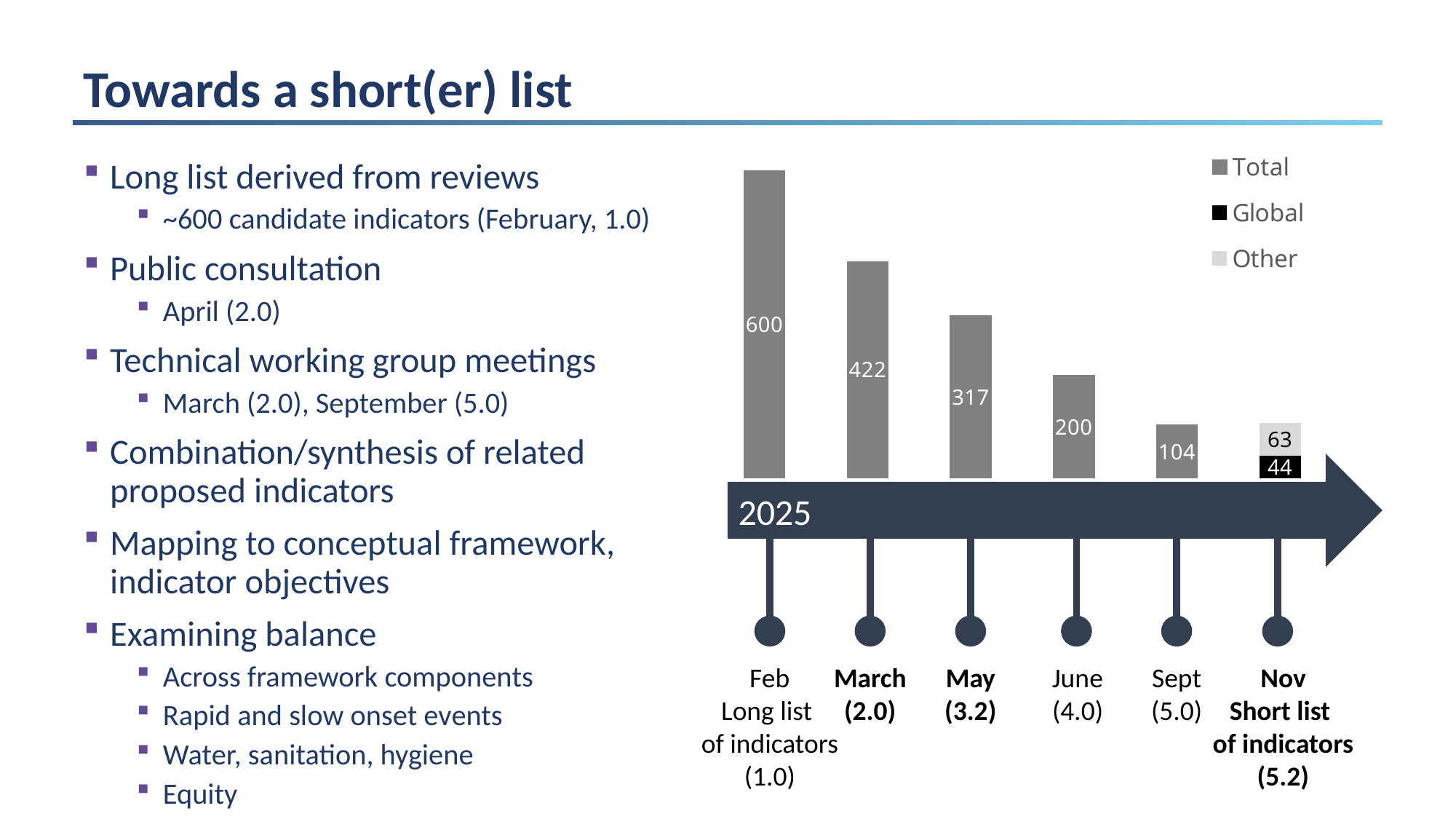
What is the Total value for May (3.2)? 317 How many series does the legend list? 3 What is the difference between the Total values for Feb and March? 178 Which is larger, the Total for June or the Total for Sept? June Which month has the highest Total value? Feb What is the Total value for March (2.0)? 422 Which month has the lowest Total value among the grey Total bars? Sept Do the Total values rise or fall from Feb to Sept? fall What is the Total value for Feb (1.0)? 600 What is the total of the stacked bar for Nov (5.2)? 107 What is the Global value for Nov (5.2)? 44 What is the Other value for Nov (5.2)? 63